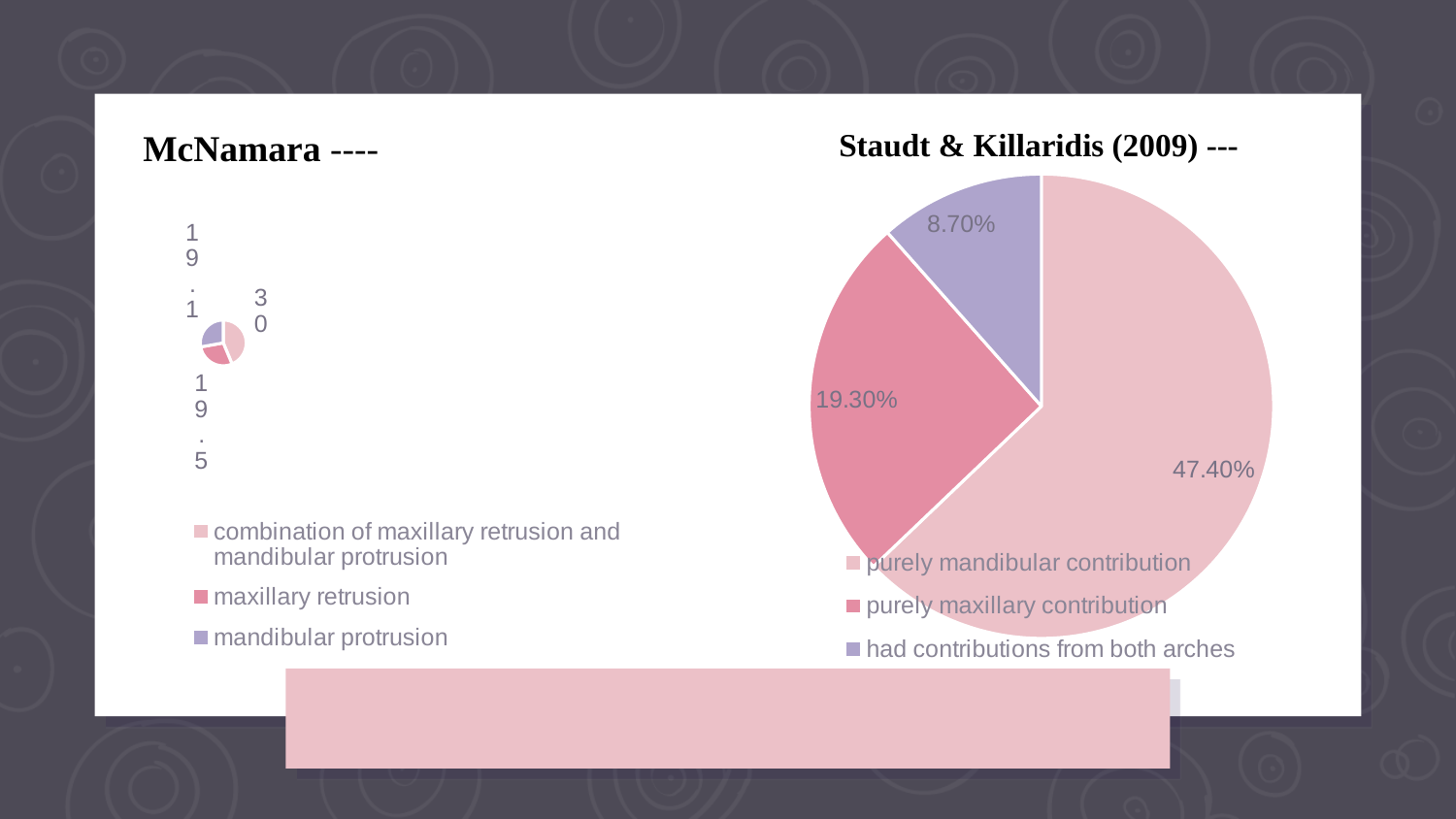
In the Staudt & Killaridis (2009) chart, what is the difference between the purely mandibular contribution and purely maxillary contribution percentages? 28.10% In the Staudt & Killaridis (2009) chart, what percentage is shown for purely maxillary contribution? 19.30% In the Staudt & Killaridis (2009) chart, which category has the smallest slice? had contributions from both arches What kind of chart is the McNamara chart on the left of the slide? pie chart What kind of chart is the Staudt & Killaridis (2009) chart on the right of the slide? pie chart How many categories does the legend of the Staudt & Killaridis (2009) chart list? 3 In the Staudt & Killaridis (2009) chart, what percentage is shown for had contributions from both arches? 8.70% In the Staudt & Killaridis (2009) chart, what is the difference between the purely maxillary contribution and had contributions from both arches percentages? 10.60% In the Staudt & Killaridis (2009) chart, what percentage is shown for purely mandibular contribution? 47.40% In the Staudt & Killaridis (2009) chart, which is larger: purely maxillary contribution or had contributions from both arches? purely maxillary contribution In the Staudt & Killaridis (2009) chart, which category has the largest slice? purely mandibular contribution How many categories does the legend of the McNamara chart on the left list? 3